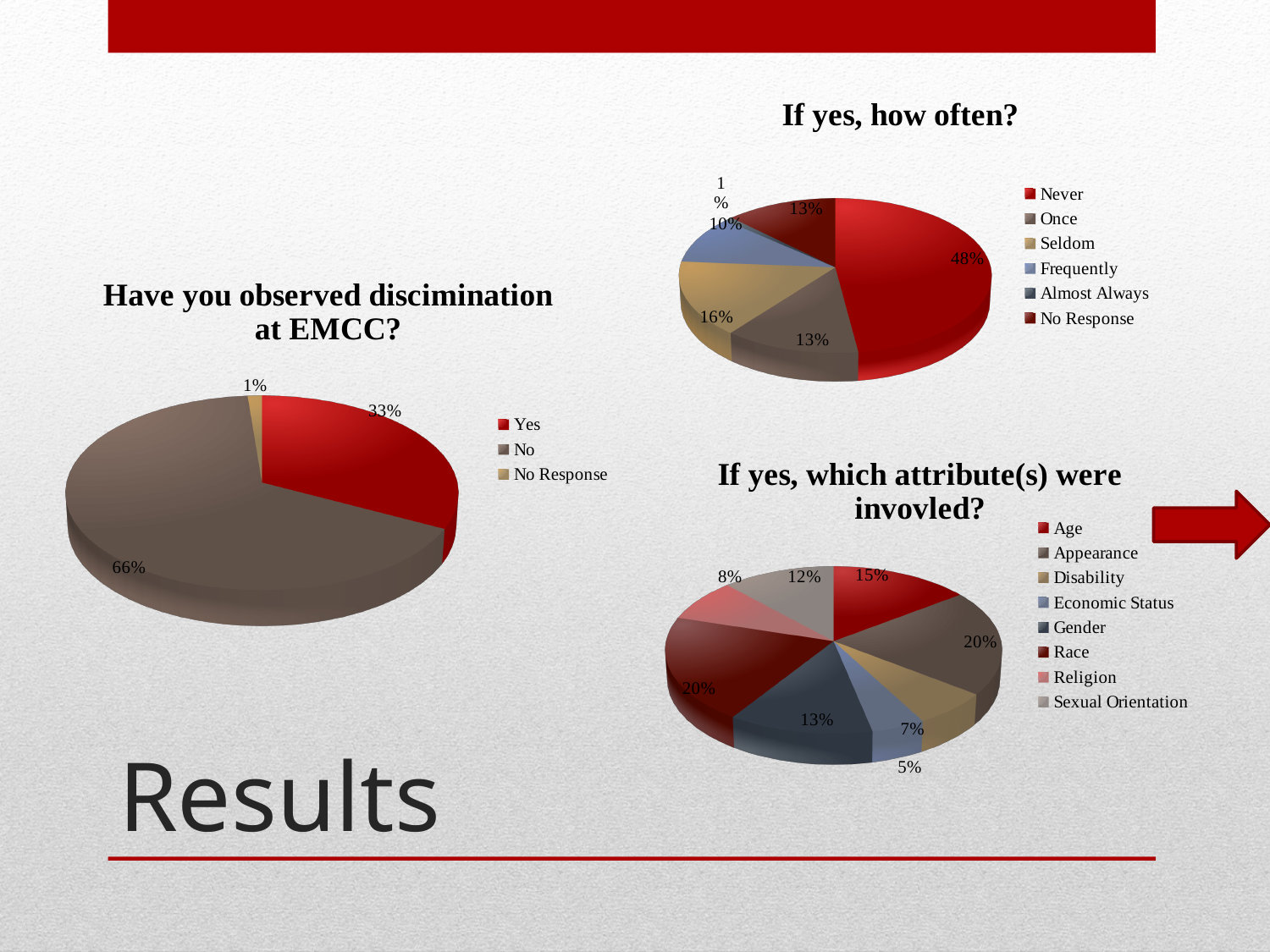
In the 'Have you observed discimination at EMCC?' chart, what percentage answered No? 66% What type of chart is used for 'Have you observed discimination at EMCC?' Pie chart In the 'Have you observed discimination at EMCC?' chart, which category has the smallest share? No Response In the 'If yes, which attribute(s) were invovled?' chart, what percentage is shown for Gender? 13% In the 'If yes, how often?' chart, what percentage is shown for Never? 48% In the 'If yes, which attribute(s) were invovled?' chart, which is larger, Age or Sexual Orientation? Age In the 'If yes, how often?' chart, what percentage is shown for Seldom? 16% In the 'If yes, how often?' chart, how many categories does the legend list? 6 In the 'If yes, which attribute(s) were invovled?' chart, how many attributes does the legend list? 8 In the 'Have you observed discimination at EMCC?' chart, what percentage answered Yes? 33% In the 'If yes, how often?' chart, what is the difference between the Never and Frequently percentages? 38% In the 'If yes, which attribute(s) were invovled?' chart, which attribute has the smallest share? Economic Status